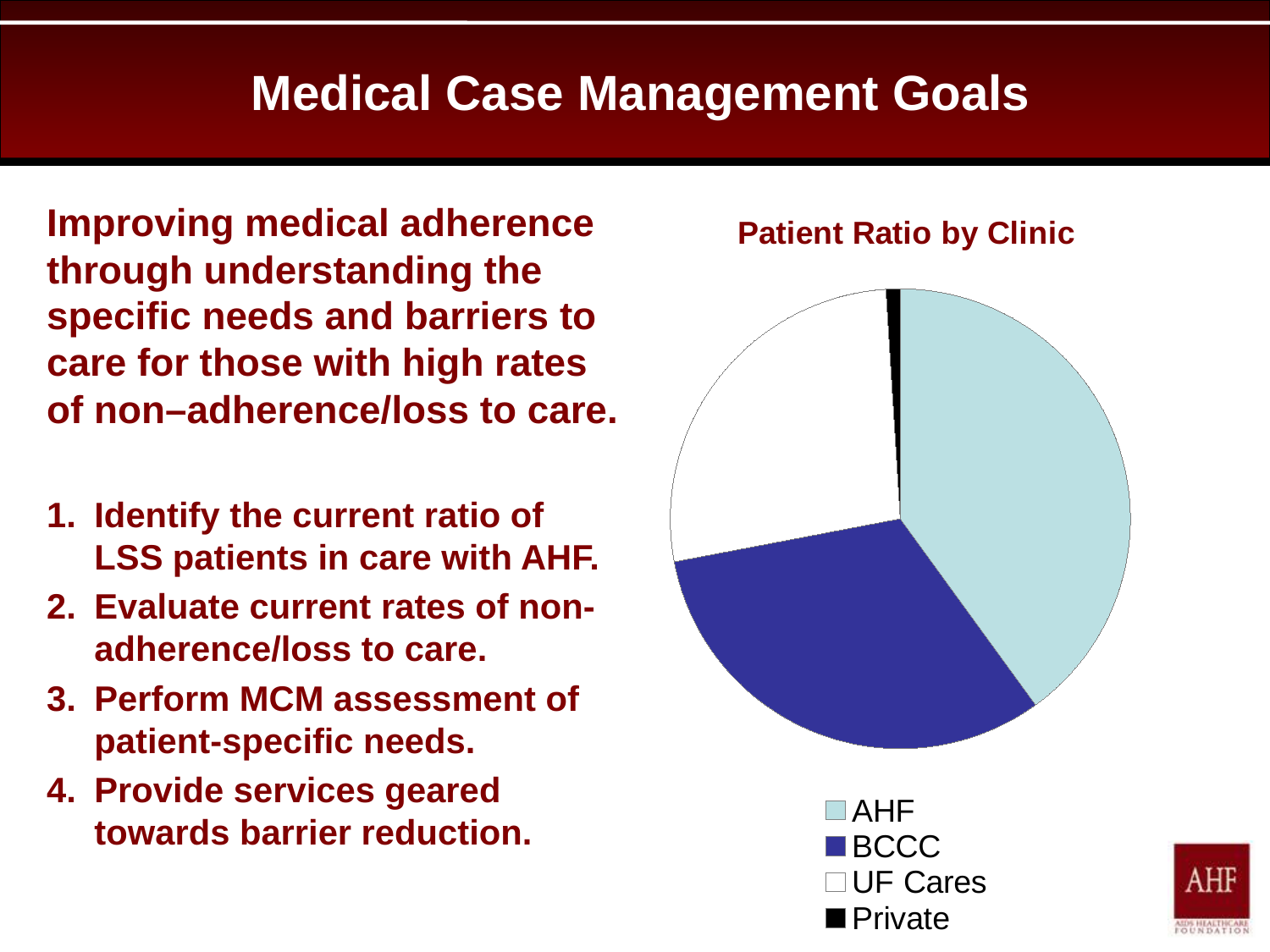
Which slice is larger in the pie chart, AHF or UF Cares? AHF Which clinic is represented by the black slice in the pie chart? Private How many slices does the pie chart have? 4 Which clinic has the smallest slice in the Patient Ratio by Clinic pie chart? Private Which clinic has the largest slice in the Patient Ratio by Clinic pie chart? AHF Which slice is larger in the pie chart, AHF or BCCC? AHF Which slice is larger in the pie chart, UF Cares or Private? UF Cares What is the title of the chart on the slide? Patient Ratio by Clinic How many entries does the legend of the pie chart list? 4 What kind of chart is shown on the slide? pie chart